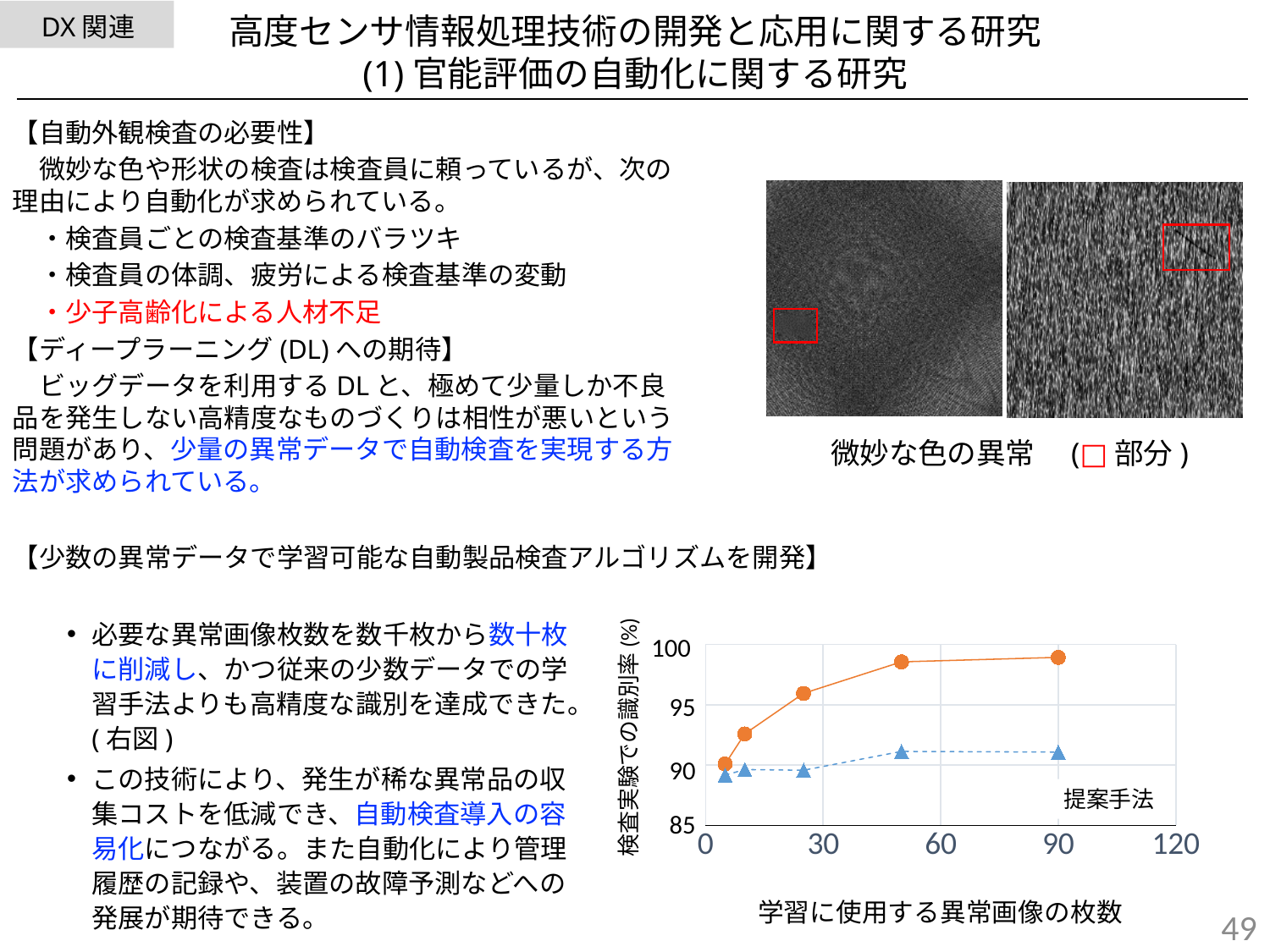
Does the 提案手法 (orange) line rise or fall as the number of abnormal images increases? rise What is the largest value shown on the y axis of the chart? 100 Is the blue triangle series value at 50 abnormal images greater or less than 90? greater What kind of chart is shown at the bottom right of the slide? line chart Is the 提案手法 value at 50 abnormal images greater or less than 95? greater At 90 abnormal images, which series has the higher recognition rate, the orange 提案手法 line or the blue triangle line? 提案手法 Is the 提案手法 value at 10 abnormal images greater or less than 95? less What is the title of the x axis of the chart? 学習に使用する異常画像の枚数 What is the title of the y axis of the chart? 検査実験での識別率 (%) How many data points does the orange 提案手法 line have? 5